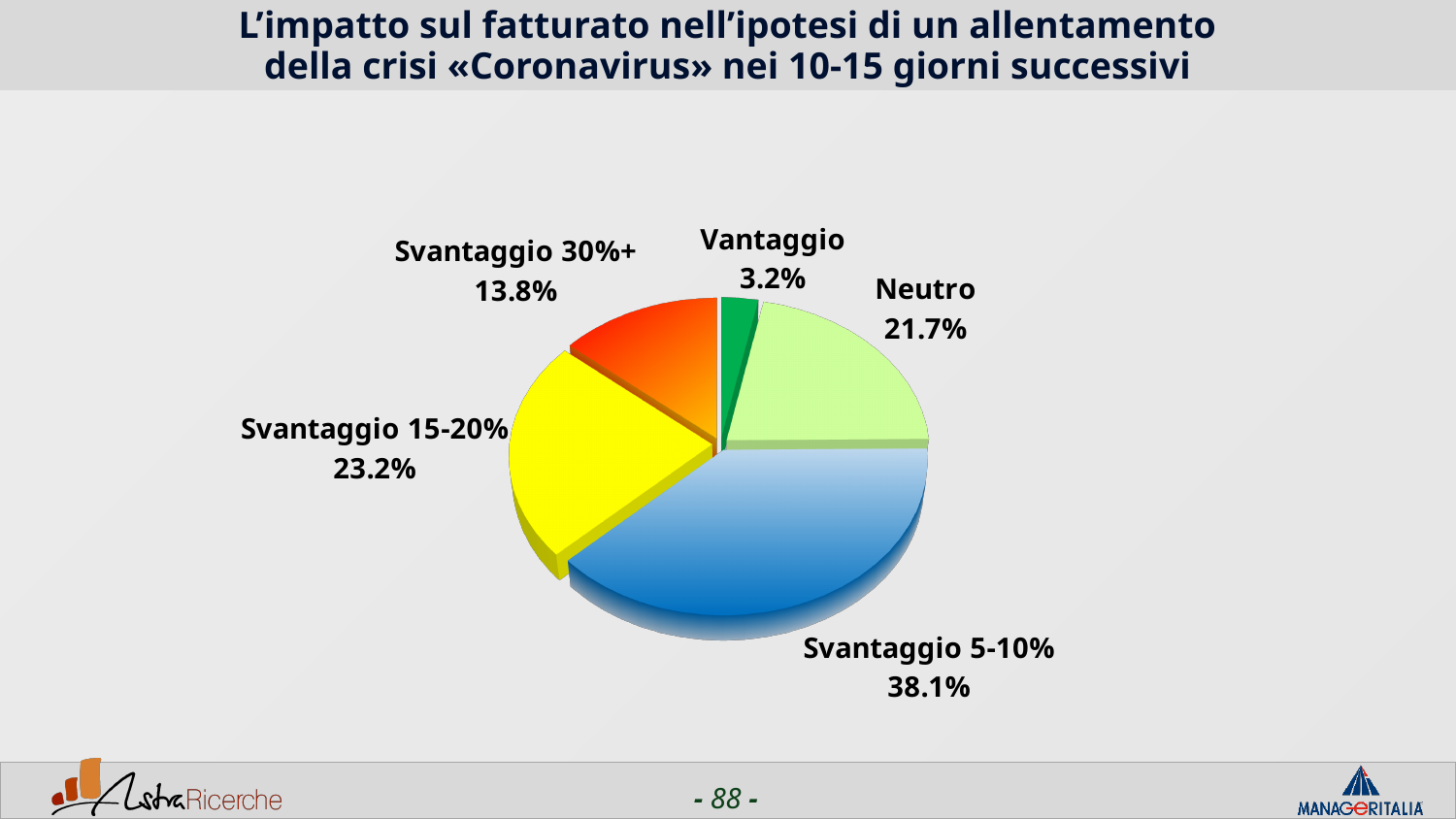
Which category has the largest slice? Svantaggio 5-10% Which is larger, Neutro or Svantaggio 30%+? Neutro What is the value for Svantaggio 30%+? 13.8% What is the value for Vantaggio? 3.2% What is the difference between Neutro and Vantaggio? 18.5% What type of chart is shown on the slide? Pie chart What is the difference between Svantaggio 5-10% and Svantaggio 15-20%? 14.9% How many slices does the pie chart have? 5 What is the value for Svantaggio 5-10%? 38.1% Which category has the smallest slice? Vantaggio What colour is the Svantaggio 15-20% slice? Yellow What is the value for Neutro? 21.7%